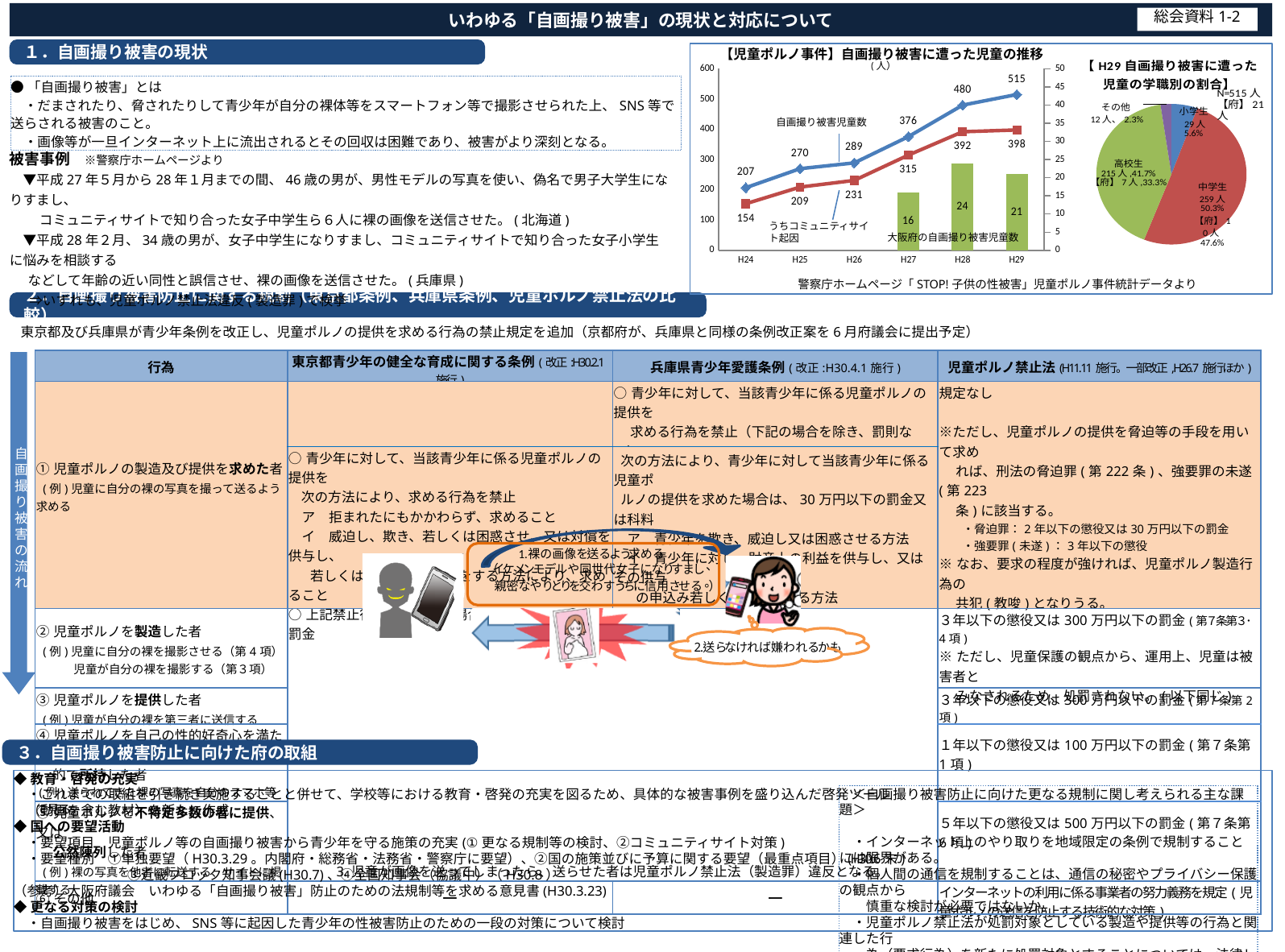
In the line chart 【児童ポルノ事件】自画撮り被害に遭った児童の推移, what is the value of 自画撮り被害児童数 for H29? 515 In the line chart 【児童ポルノ事件】自画撮り被害に遭った児童の推移, which year has the lowest value of 自画撮り被害児童数? H24 In the pie chart 【H29 自画撮り被害に遭った児童の学職別の割合】, how many people are in the 高校生 slice? 215人 In the line chart 【児童ポルノ事件】自画撮り被害に遭った児童の推移, which year has the highest value of 大阪府の自画撮り被害児童数? H28 In the line chart 【児童ポルノ事件】自画撮り被害に遭った児童の推移, what is the difference between 自画撮り被害児童数 and うちコミュニティサイト起因 in H29? 117 In the line chart 【児童ポルノ事件】自画撮り被害に遭った児童の推移, does 自画撮り被害児童数 rise or fall from H24 to H29? rise In the pie chart 【H29 自画撮り被害に遭った児童の学職別の割合】, which is larger, 小学生 or その他? 小学生 In the pie chart 【H29 自画撮り被害に遭った児童の学職別の割合】, what share of the pie is 中学生? 50.3% In the line chart 【児童ポルノ事件】自画撮り被害に遭った児童の推移, how many years are shown on the x axis? 6 In the pie chart 【H29 自画撮り被害に遭った児童の学職別の割合】, which category has the smallest slice? その他 In the line chart 【児童ポルノ事件】自画撮り被害に遭った児童の推移, what is the value of 大阪府の自画撮り被害児童数 for H28? 24 In the line chart 【児童ポルノ事件】自画撮り被害に遭った児童の推移, what is the value of うちコミュニティサイト起因 for H27? 315